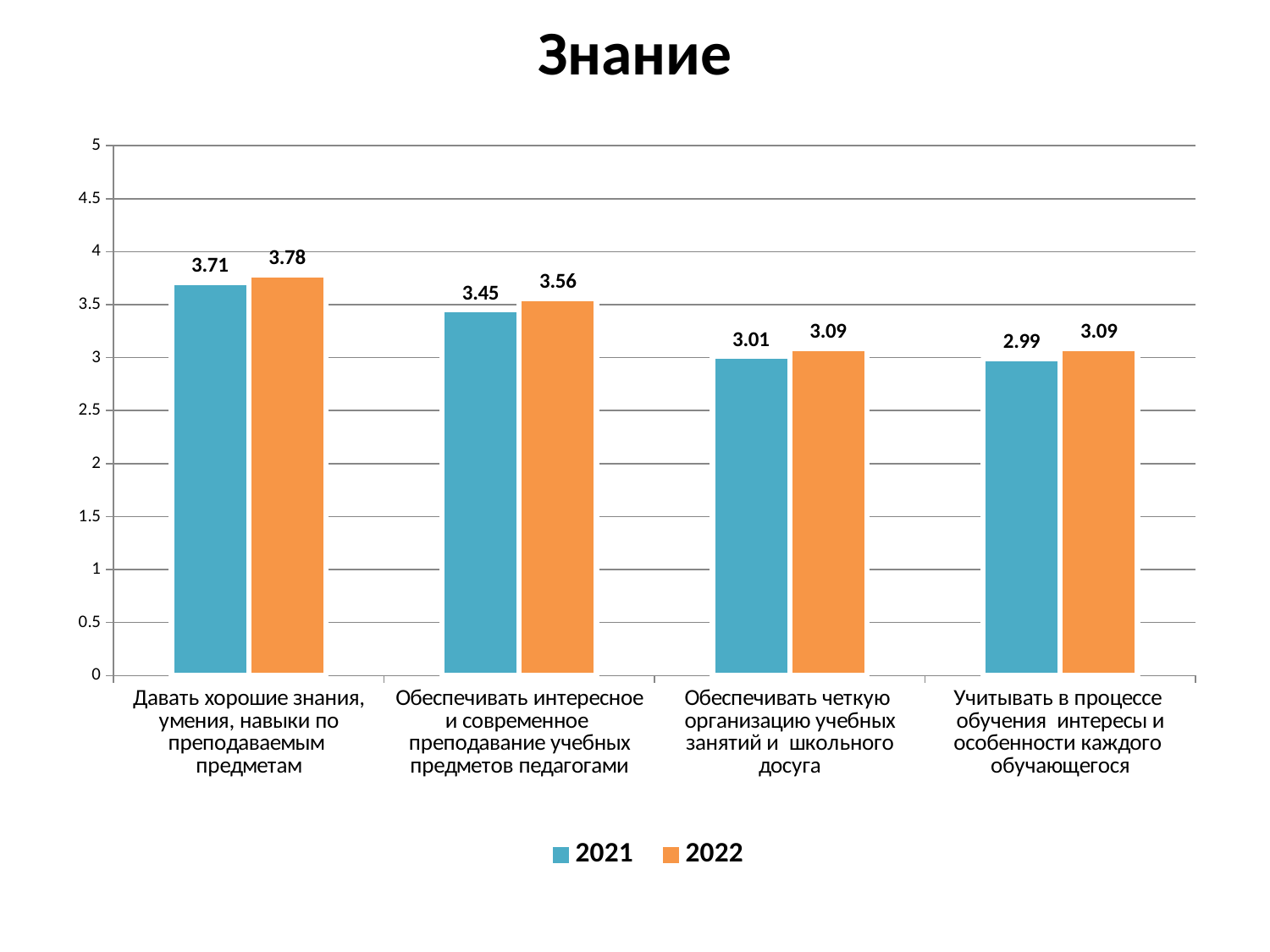
Which is larger for "Обеспечивать четкую организацию учебных занятий и школьного досуга": the 2021 value or the 2022 value? 2022 What is the 2022 value for "Обеспечивать интересное и современное преподавание учебных предметов педагогами"? 3.56 Is the 2021 value for "Давать хорошие знания, умения, навыки по преподаваемым предметам" greater or less than 3.5? greater What is the 2021 value for "Давать хорошие знания, умения, навыки по преподаваемым предметам"? 3.71 What is the 2021 value for "Учитывать в процессе обучения интересы и особенности каждого обучающегося"? 2.99 What is the title of the chart? Знание Which category has the lowest 2021 value? Учитывать в процессе обучения интересы и особенности каждого обучающегося What is the difference between the 2022 and 2021 values for "Обеспечивать интересное и современное преподавание учебных предметов педагогами"? 0.11 What kind of chart is shown on the slide? bar chart How many categories are shown on the x axis? 4 Which category has the highest 2022 value? Давать хорошие знания, умения, навыки по преподаваемым предметам How many series does the legend list? 2